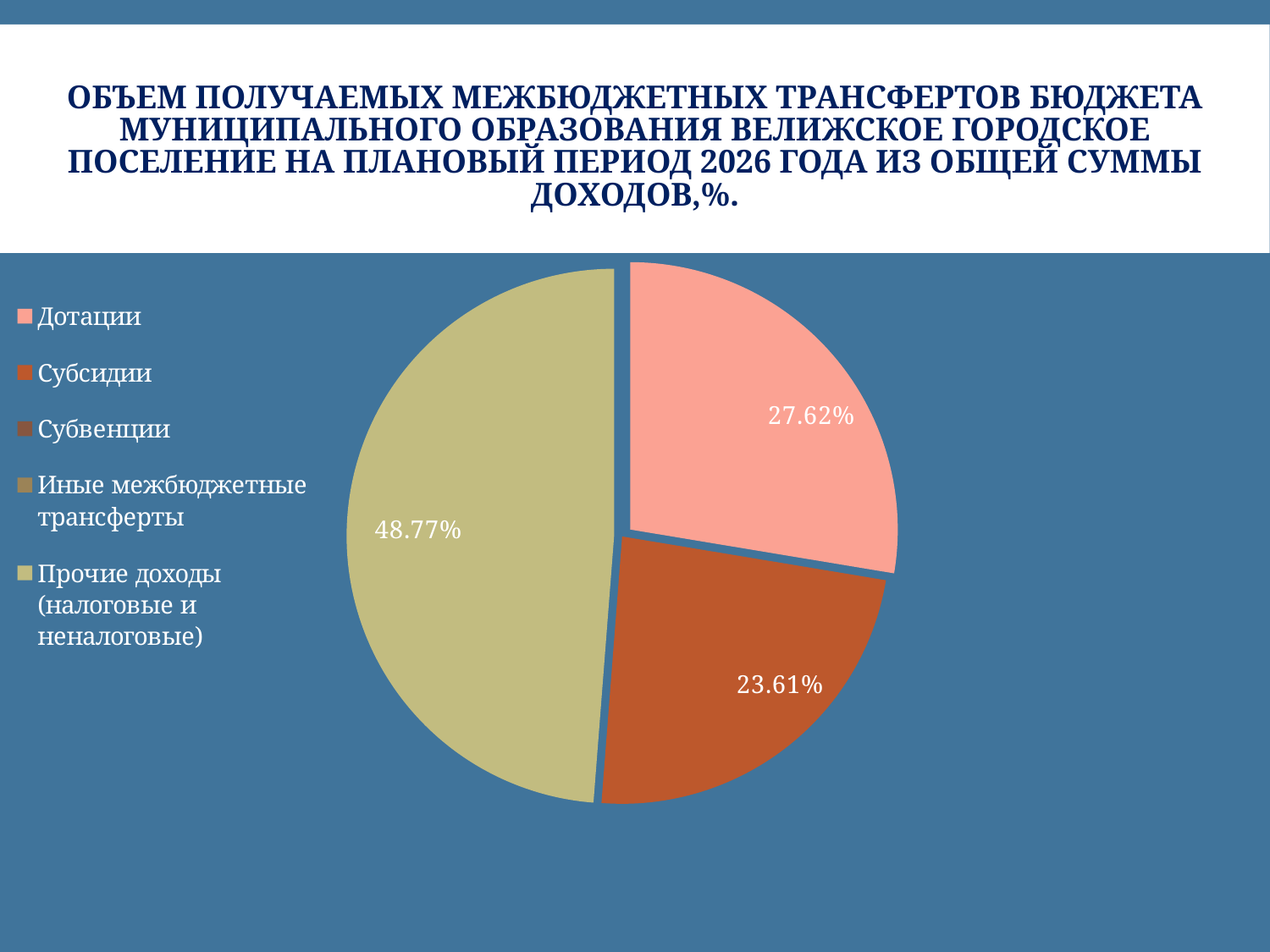
What share of the pie does the Дотации slice represent? 27.62% How many slices with printed value labels are visible in the pie? 3 Which slice is larger, Дотации or Субсидии? Дотации What percentage is labelled on the Прочие доходы (налоговые и неналоговые) slice? 48.77% What colour is the Дотации slice? Pink What kind of chart is shown on the slide? Pie chart How many entries does the legend list? 5 Which category has the largest slice of the pie? Прочие доходы (налоговые и неналоговые) By how many percentage points does the Прочие доходы slice exceed the Дотации slice? 21.15 What is the difference between the Дотации and Субсидии values? 4.01 What value is shown for the Субсидии slice? 23.61% Of the slices with printed values, which is the smallest? Субсидии